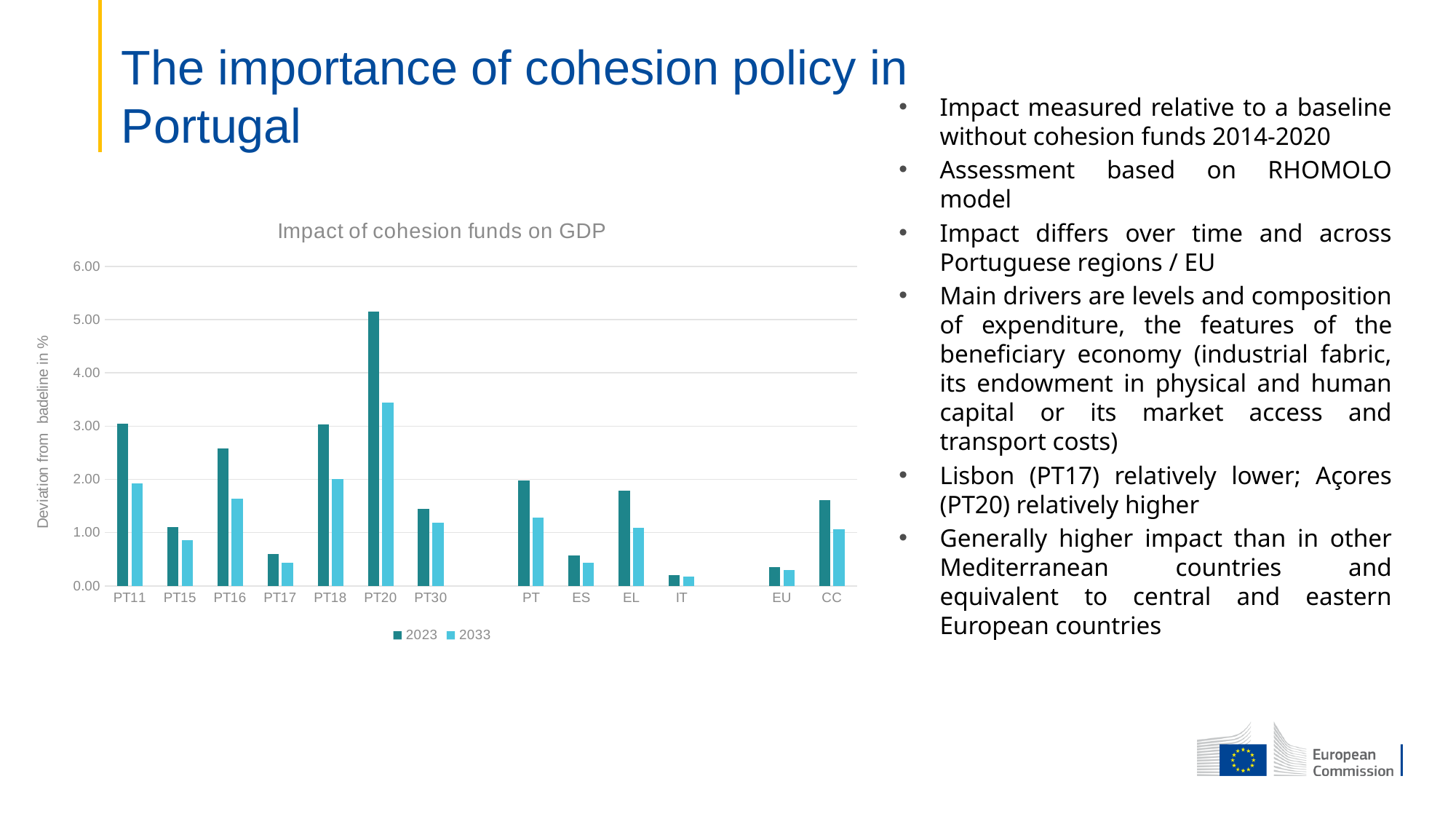
What kind of chart is shown on the slide? Bar chart Is the 2023 value for EU greater or less than 1.00? less Is the 2033 value for PT20 greater or less than 3.00? greater What is the title of the chart? Impact of cohesion funds on GDP Which category has the highest value for 2033? PT20 Which category has the lowest value for 2023? IT For PT11, which series has the larger value, 2023 or 2033? 2023 Is the 2023 value for PT16 greater or less than 2.00? greater How many series does the legend list? 2 Which category has the highest value for 2023? PT20 How many labelled categories are shown on the x axis? 13